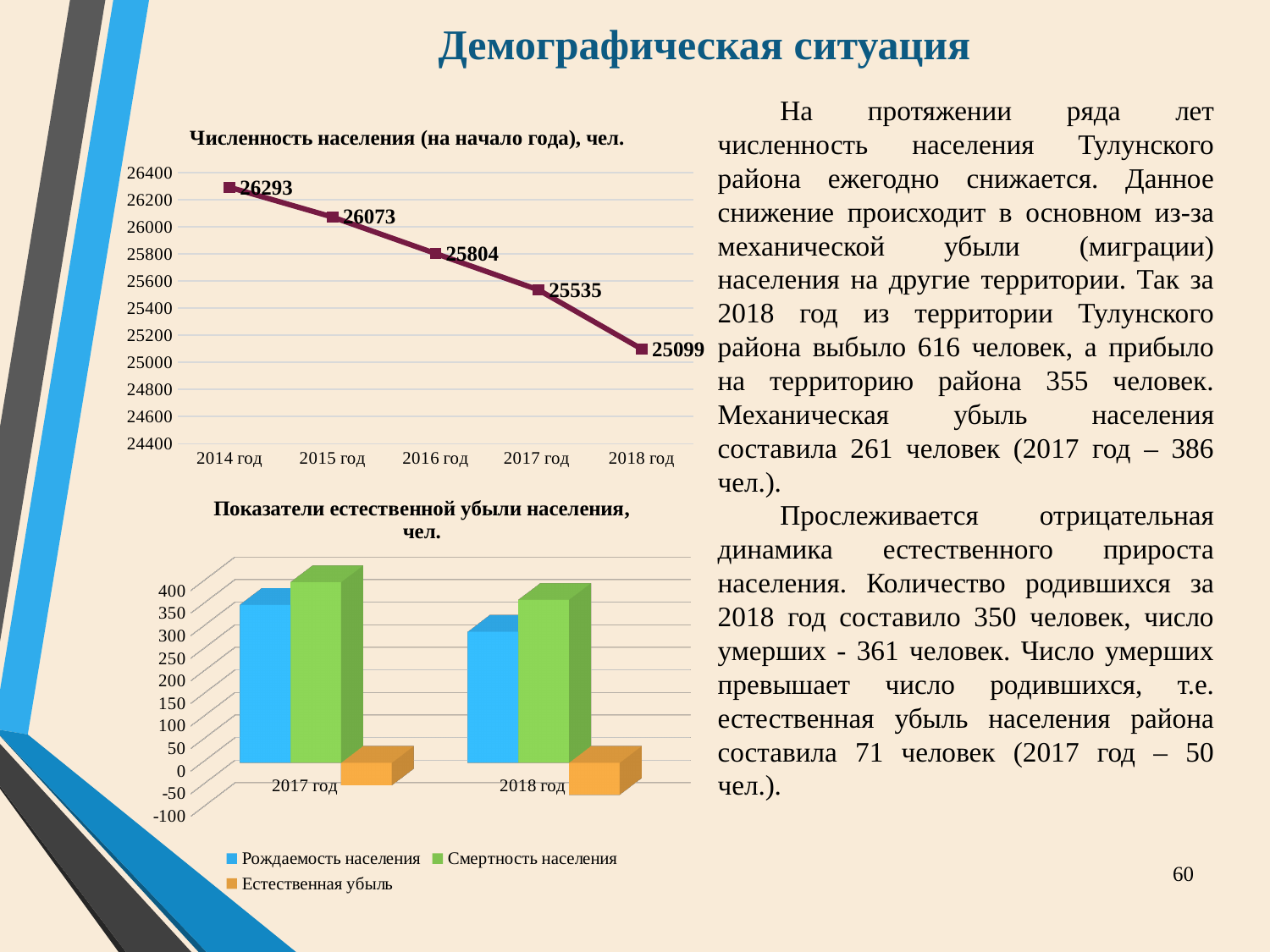
How many data points are plotted in the top chart 'Численность населения (на начало года), чел.'? 5 In the top chart 'Численность населения (на начало года), чел.', what is the value for 2014 год? 26293 How many series does the legend of the bottom chart 'Показатели естественной убыли населения, чел.' list? 3 In the top chart 'Численность населения (на начало года), чел.', do the values rise or fall from 2014 год to 2018 год? fall In the top chart 'Численность населения (на начало года), чел.', what is the value for 2018 год? 25099 In the top chart 'Численность населения (на начало года), чел.', which year has the lowest value? 2018 год In the top chart 'Численность населения (на начало года), чел.', which year has the highest value? 2014 год In the top chart 'Численность населения (на начало года), чел.', what is the difference between the values for 2014 год and 2018 год? 1194 In the bottom chart 'Показатели естественной убыли населения, чел.', for 2017 год, which is larger: Рождаемость населения or Смертность населения? Смертность населения What kind of chart is the top chart 'Численность населения (на начало года), чел.'? line chart In the top chart 'Численность населения (на начало года), чел.', what is the value for 2016 год? 25804 In the bottom chart 'Показатели естественной убыли населения, чел.', is the value of Естественная убыль for 2018 год greater or less than 0? less